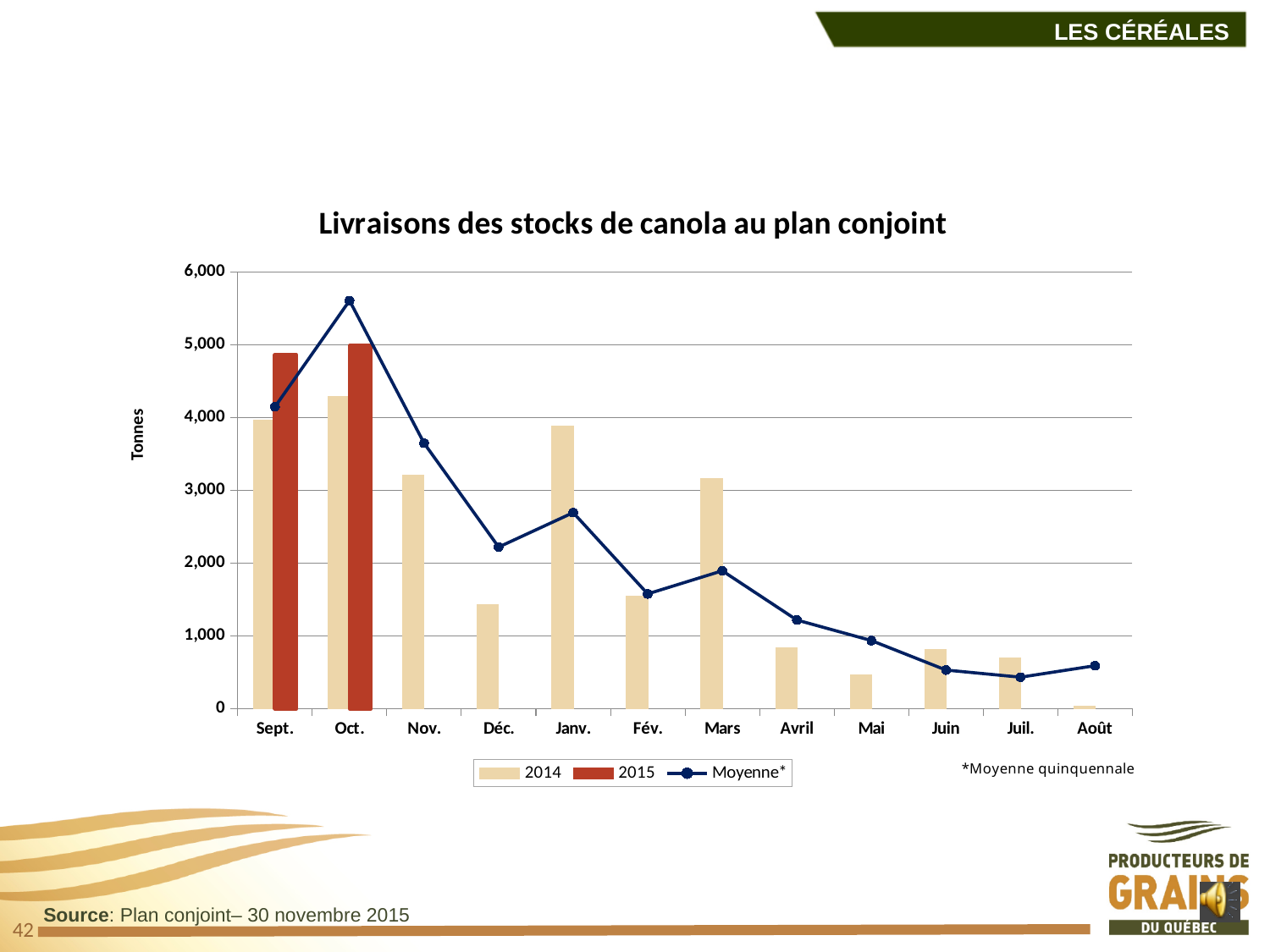
How many months are shown on the x axis? 12 What kind of chart is shown on the slide? A bar chart combined with a line In which month is the 2014 bar lowest? Août Is the 2014 value for Nov. greater or less than 3,000? greater In Janv., which is larger, the 2014 bar or the Moyenne* line? 2014 What is the label on the vertical axis? Tonnes In which month does the Moyenne* line reach its highest point? Oct. Which is larger in Sept., the 2014 bar or the 2015 bar? 2015 For how many months is a 2015 bar plotted? 2 How many series does the legend list? 3 In which month is the 2014 bar highest? Oct. Is the 2015 value for Sept. greater or less than 4,000? greater